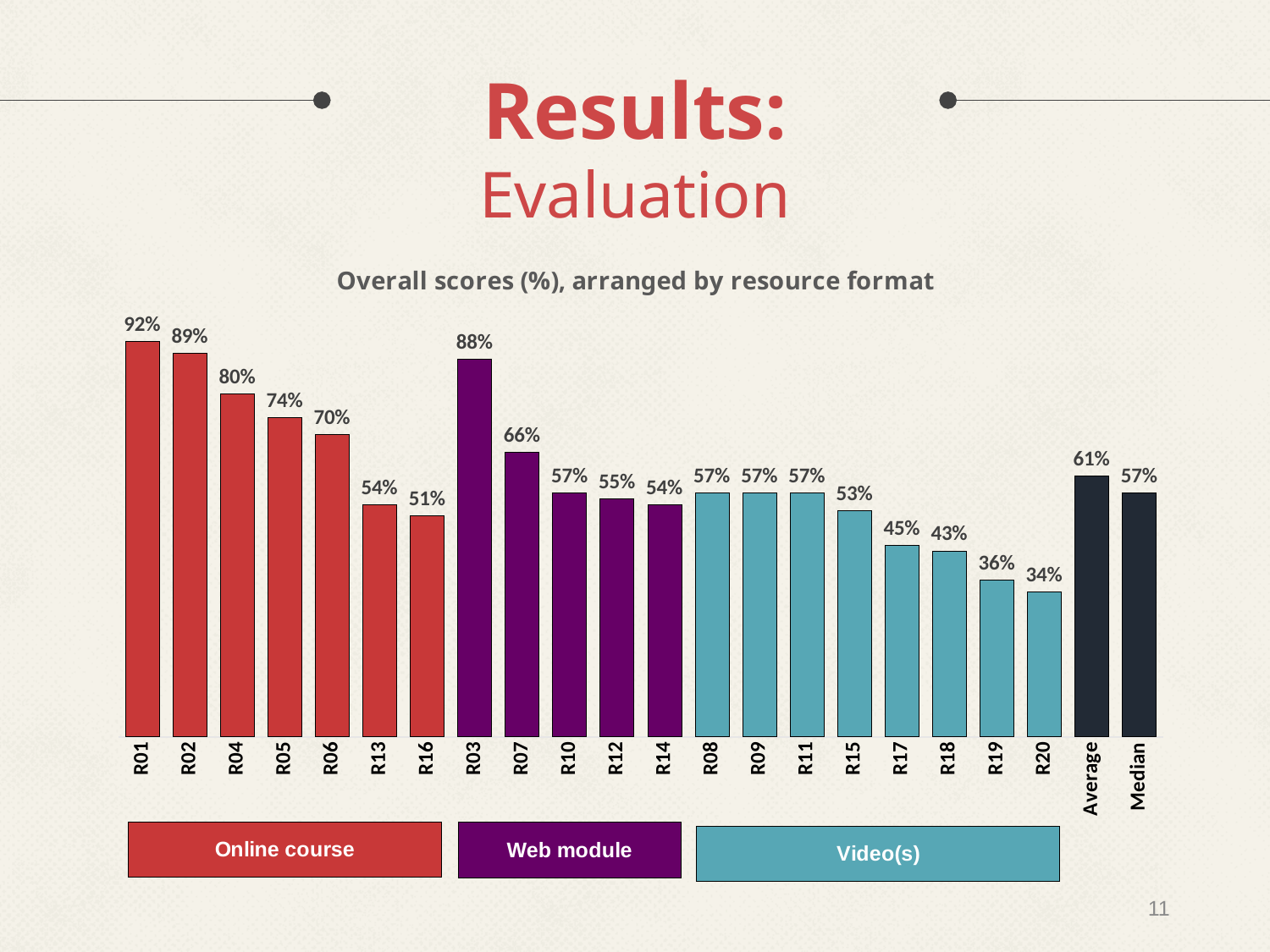
What is the difference between the Average and the Median values? 4% Which resource has the highest overall score? R01 What is the Average value shown in the chart? 61% Which has a higher overall score, R07 or R15? R07 What is the difference between the overall scores of R01 and R02? 3% What type of chart is shown on the slide? Bar chart What is the overall score for R01? 92% What is the Median value shown in the chart? 57% How many bars are plotted in the chart, including Average and Median? 22 Which resource has the lowest overall score? R20 What is the overall score for R20? 34% What is the overall score for R03? 88%